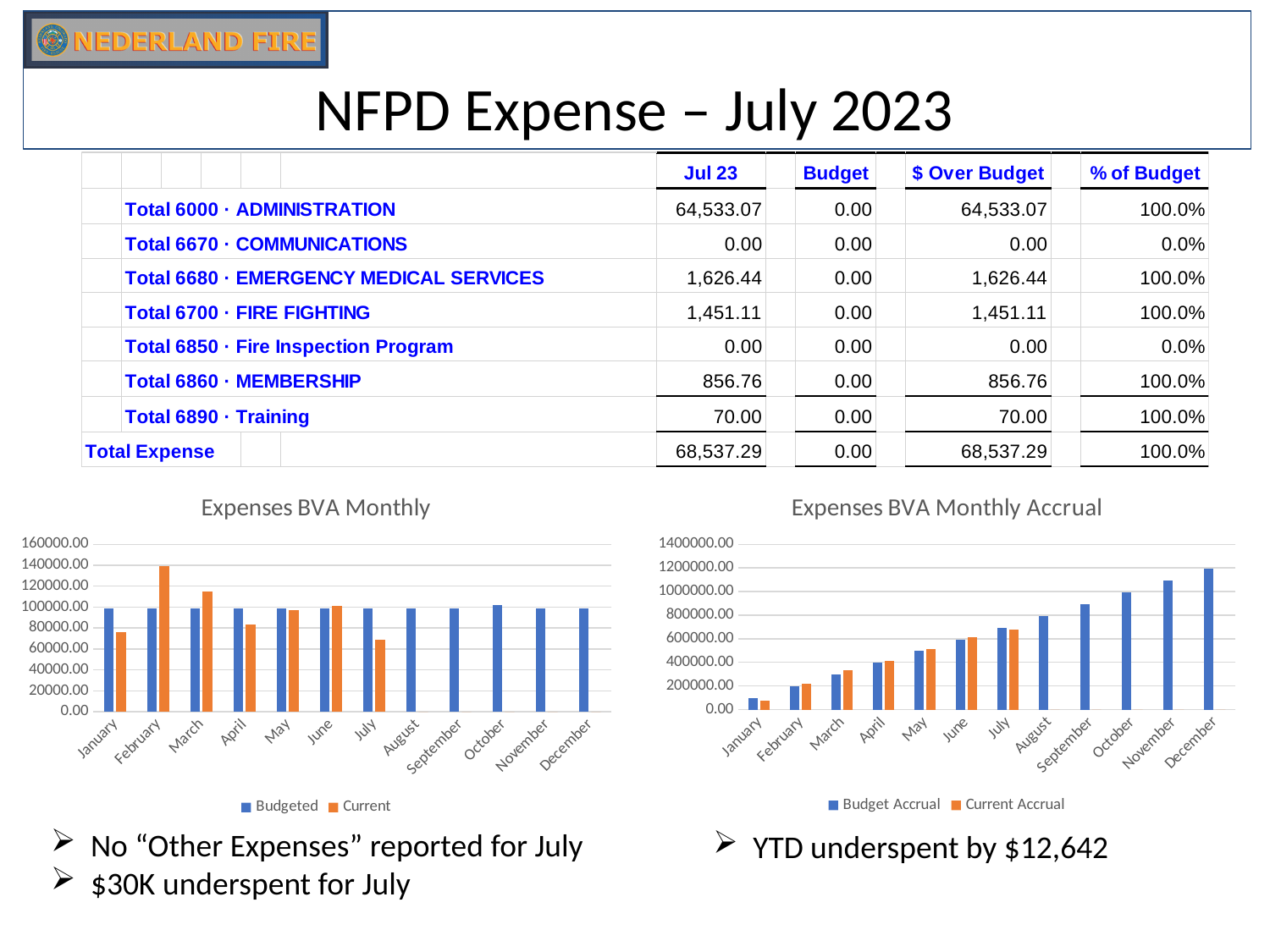
In the 'Expenses BVA Monthly' chart, what are the two legend entries? Budgeted and Current In the 'Expenses BVA Monthly' chart, how many series does the legend list? 2 In the 'Expenses BVA Monthly Accrual' chart, do the Budget Accrual values rise or fall from January to December? Rise In the 'Expenses BVA Monthly' chart, for March, which is larger: Budgeted or Current? Current What kind of chart is the 'Expenses BVA Monthly' chart? Bar chart In the 'Expenses BVA Monthly' chart, is the Current value for February greater or less than 120000.00? greater In the 'Expenses BVA Monthly' chart, is the Current value for July greater or less than 80000.00? less In the 'Expenses BVA Monthly' chart, how many months are shown on the x axis? 12 In the 'Expenses BVA Monthly' chart, which month has the lowest Current value among the months with a Current bar? July In the 'Expenses BVA Monthly Accrual' chart, how many series does the legend list? 2 In the 'Expenses BVA Monthly Accrual' chart, is the Budget Accrual value for December greater or less than 1000000.00? greater In the 'Expenses BVA Monthly' chart, which month has the highest Current value? February